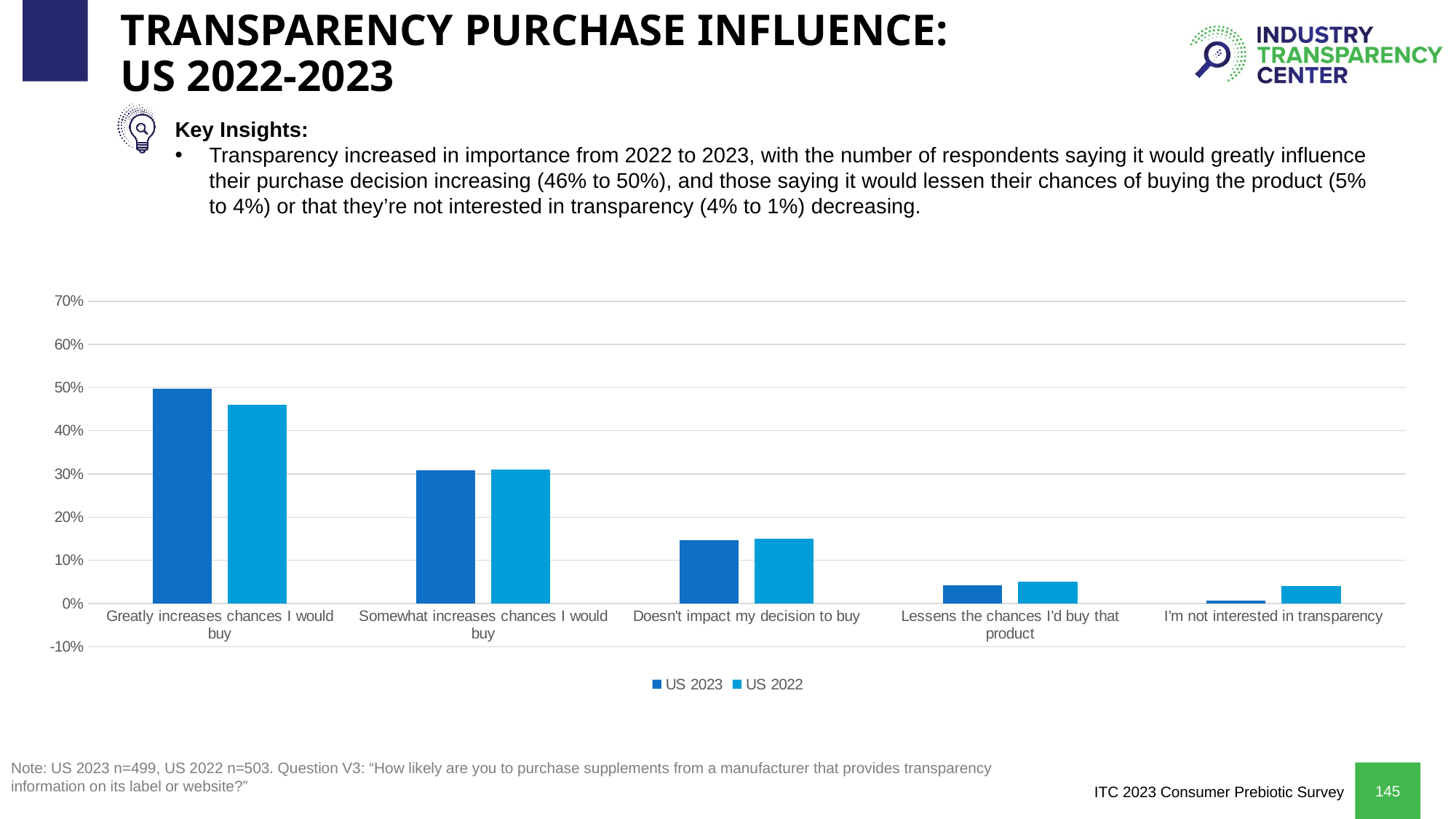
What are the two entries in the chart legend? US 2023 and US 2022 Which category has the highest value for US 2023? Greatly increases chances I would buy For 'I'm not interested in transparency', which series has the larger value, US 2023 or US 2022? US 2022 Is the US 2022 value for 'Greatly increases chances I would buy' greater or less than 40%? greater Which category has the highest value for US 2022? Greatly increases chances I would buy Do the US 2023 values rise or fall moving from left to right across the categories? fall How many response categories are shown on the x axis? 5 For 'Greatly increases chances I would buy', which series has the larger value, US 2023 or US 2022? US 2023 Is the US 2023 value for 'Doesn't impact my decision to buy' greater or less than 20%? less How many series does the legend list? 2 Which category has the lowest value for US 2023? I'm not interested in transparency What kind of chart is shown on the slide? bar chart